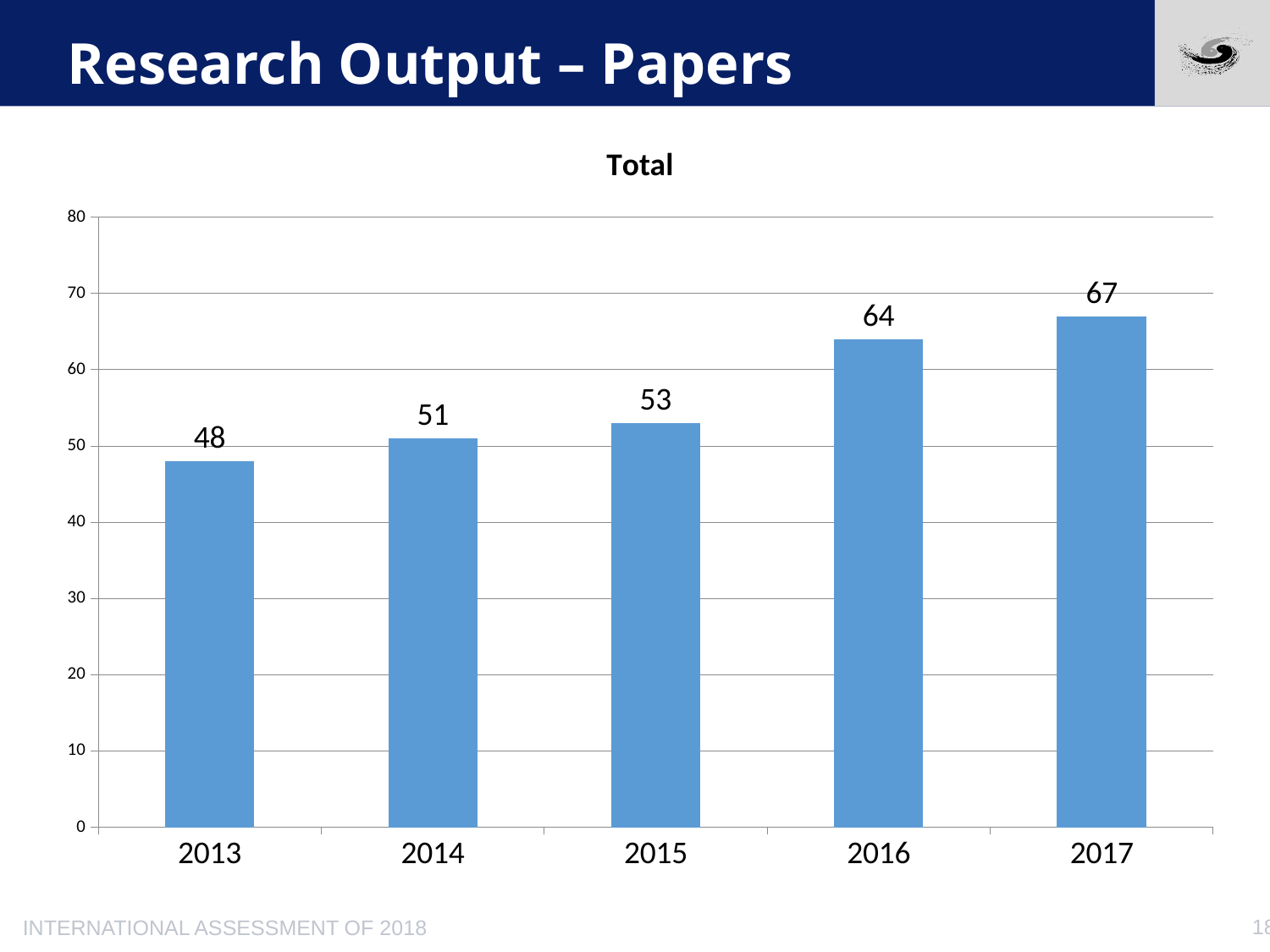
Do the values rise or fall from 2013 to 2017? rise What kind of chart is shown on the slide? bar chart How many years are shown on the x axis? 5 Which is larger, the value for 2014 or the value for 2015? 2015 Is the value for 2016 greater or less than 60? greater Which year has the lowest value? 2013 What is the title of the chart? Total What is the value for 2013? 48 Which year has the highest value? 2017 What is the difference between the values for 2017 and 2013? 19 What is the difference between the values for 2016 and 2015? 11 What is the value for 2016? 64